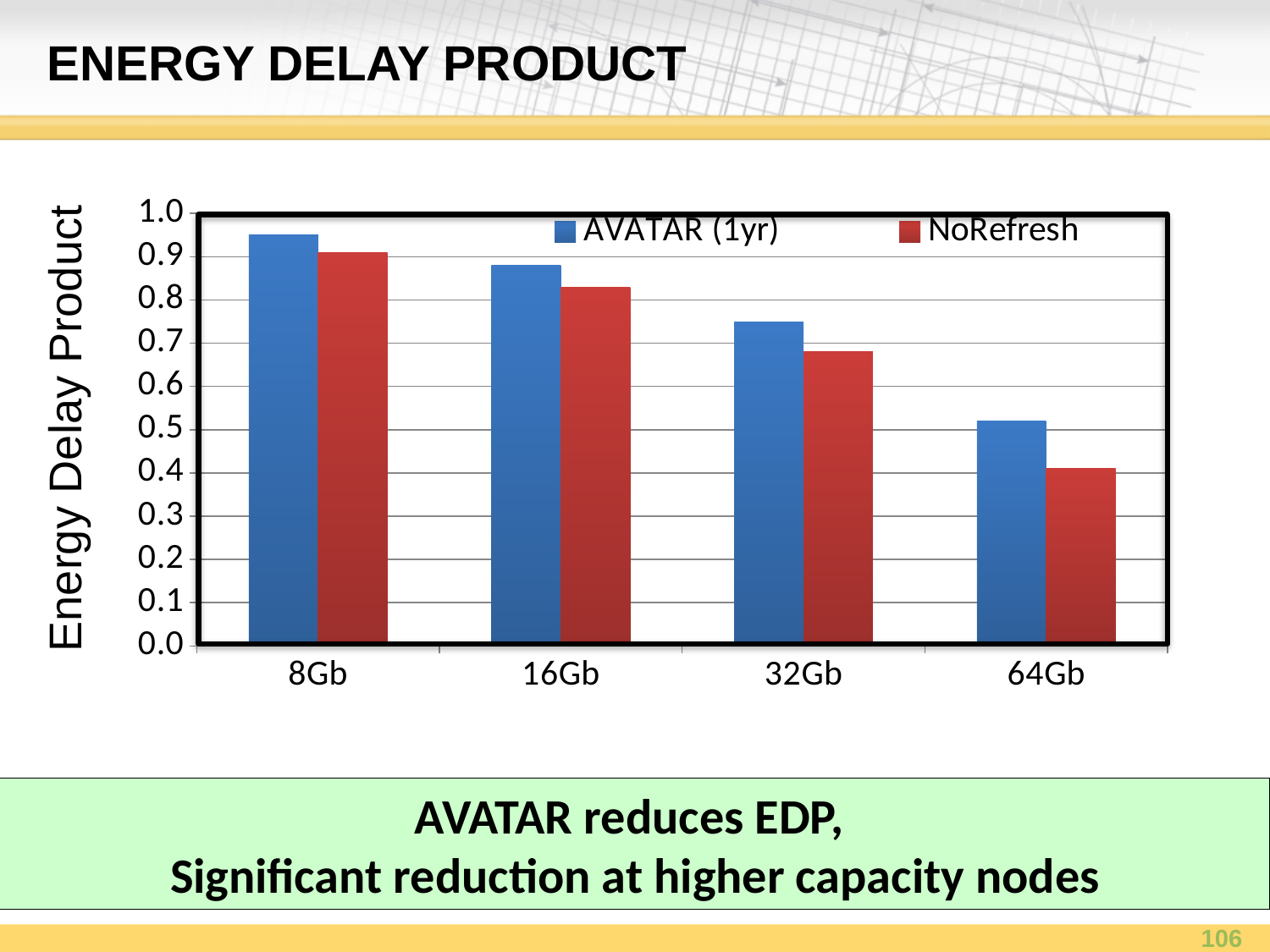
Is the AVATAR (1yr) value for 32Gb greater or less than 0.7? greater Which capacity has the lowest NoRefresh value? 64Gb What is the title of the y axis? Energy Delay Product How many capacity categories are shown on the x axis? 4 Do the NoRefresh values rise or fall as capacity increases from 8Gb to 64Gb? fall Is the NoRefresh value for 16Gb greater or less than 0.8? greater Which capacity has the highest AVATAR (1yr) value? 8Gb At 64Gb, which is larger: AVATAR (1yr) or NoRefresh? AVATAR (1yr) Is the AVATAR (1yr) value for 8Gb greater or less than 0.9? greater How many series does the legend list? 2 What kind of chart is shown on the slide? bar chart